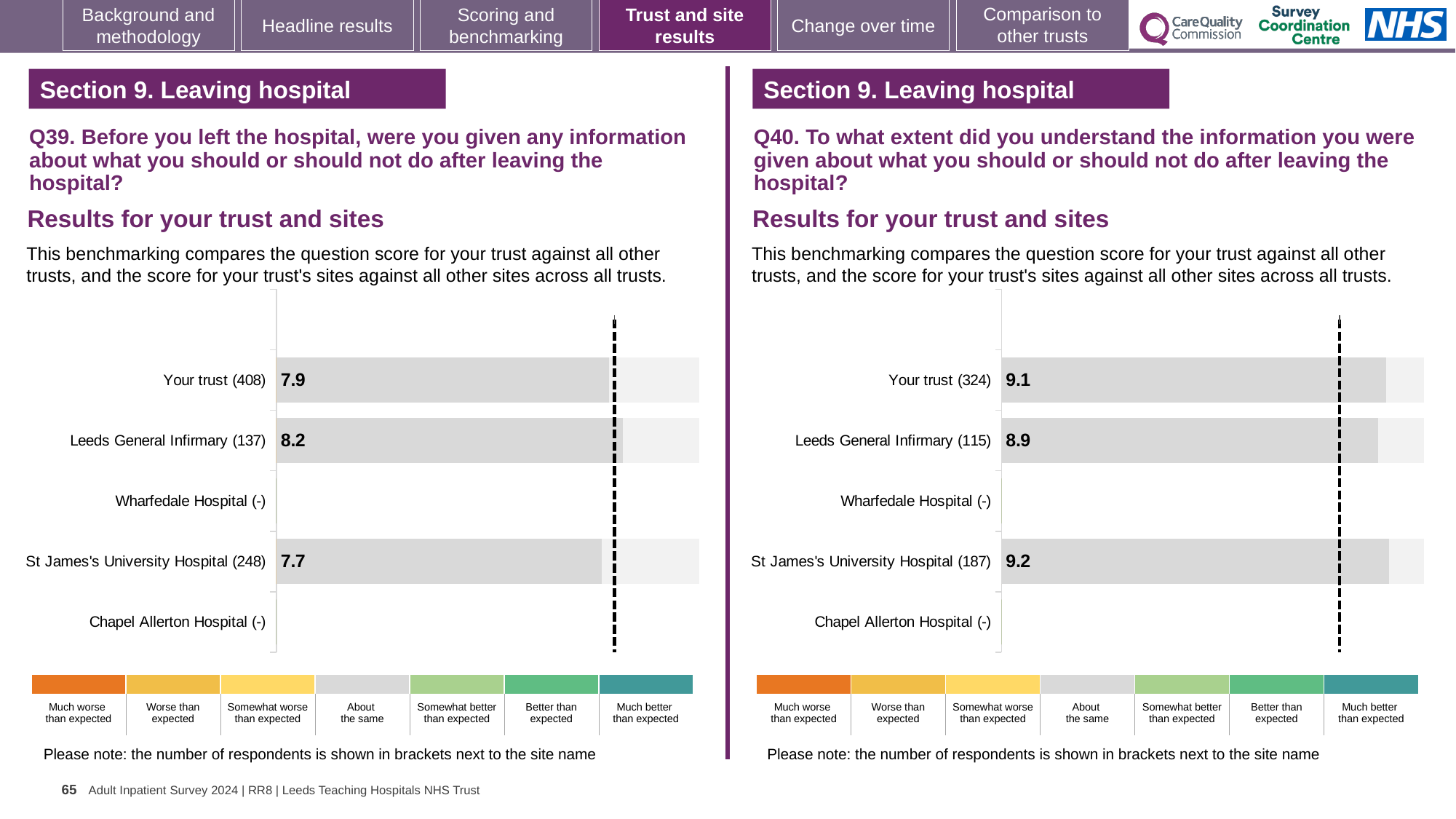
In the Q39 chart on the left, what is the difference between the scores for Leeds General Infirmary and St James's University Hospital? 0.5 In the Q39 chart on the left, what is the score for Leeds General Infirmary? 8.2 What kind of chart is used for the Q40 results on the right? Bar chart In the Q39 chart on the left, what is the score for St James's University Hospital? 7.7 In the Q40 chart on the right, which site or trust has the lowest plotted score? Leeds General Infirmary In the Q39 chart on the left, what is the score for Your trust? 7.9 In the Q40 chart on the right, what is the score for Your trust? 9.1 In the Q39 chart on the left, which site or trust has the highest score? Leeds General Infirmary How many categories (trust and sites) are listed on the Q39 chart on the left? 5 In the Q40 chart on the right, what is the score for St James's University Hospital? 9.2 In the Q40 chart on the right, how many respondents are shown in brackets for Your trust? 324 In the Q40 chart on the right, which has the larger score: Your trust or Leeds General Infirmary? Your trust